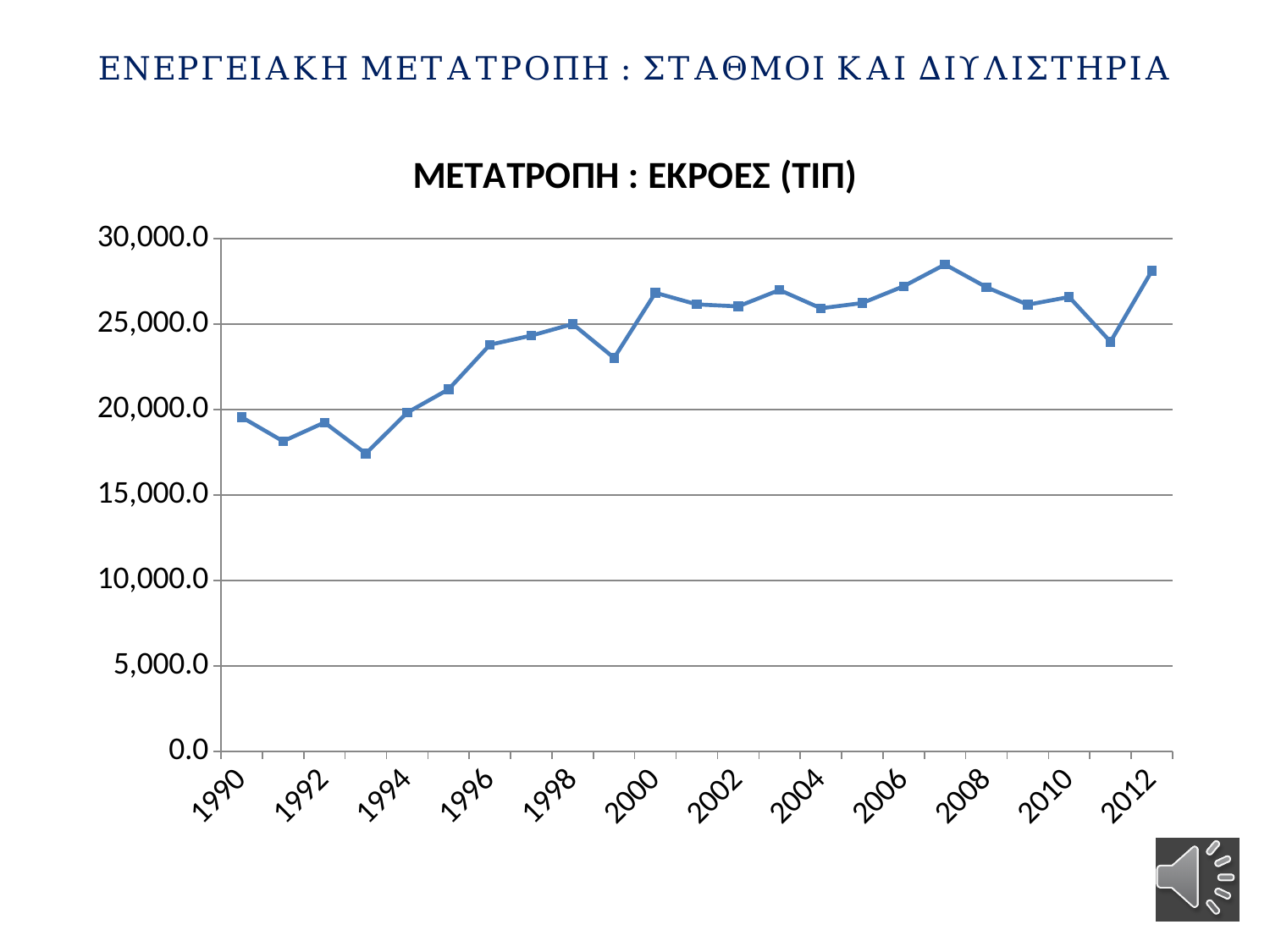
Which is larger, the value for 1999 or the value for 2000? 2000 Is the value for 1990 greater or less than 20,000.0? less Is the value for 1995 greater or less than 20,000.0? greater How many data points are plotted on the line? 23 Overall, do the values rise or fall from 1990 to 2012? rise Which is larger, the value for 1990 or the value for 1993? 1990 Is the value for 2000 greater or less than 25,000.0? greater Which year has the lowest value? 1993 What kind of chart is shown on the slide? line chart What is the title of the chart? ΜΕΤΑΤΡΟΠΗ : ΕΚΡΟΕΣ (ΤΙΠ)